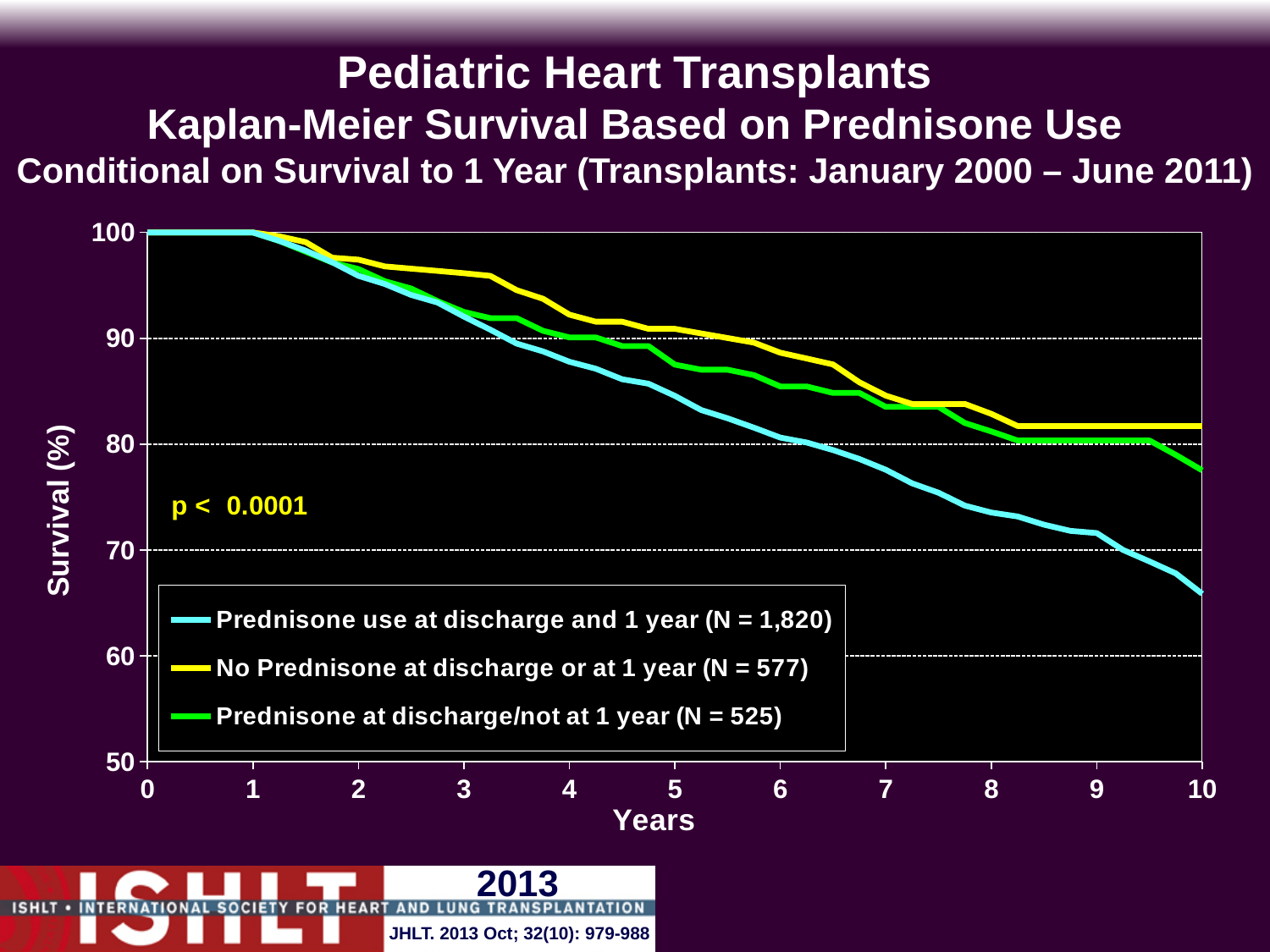
At year 10, which series has higher survival: 'No Prednisone at discharge or at 1 year' or 'Prednisone use at discharge and 1 year'? No Prednisone at discharge or at 1 year What p-value is printed on the chart? p < 0.0001 Do the survival curves rise or fall as years increase? fall Is the survival value for 'Prednisone use at discharge and 1 year' at year 5 greater or less than 80? greater How many series does the legend list? 3 What is the survival value for the 'Prednisone use at discharge and 1 year' series at year 1? 100 What kind of chart is shown on the slide? line chart What is the survival value for the 'No Prednisone at discharge or at 1 year' series at year 0? 100 Is the survival value for 'Prednisone use at discharge and 1 year' at year 10 greater or less than 70? less Is the survival value for 'No Prednisone at discharge or at 1 year' at year 10 greater or less than 80? greater Which series has the lowest survival at year 10? Prednisone use at discharge and 1 year